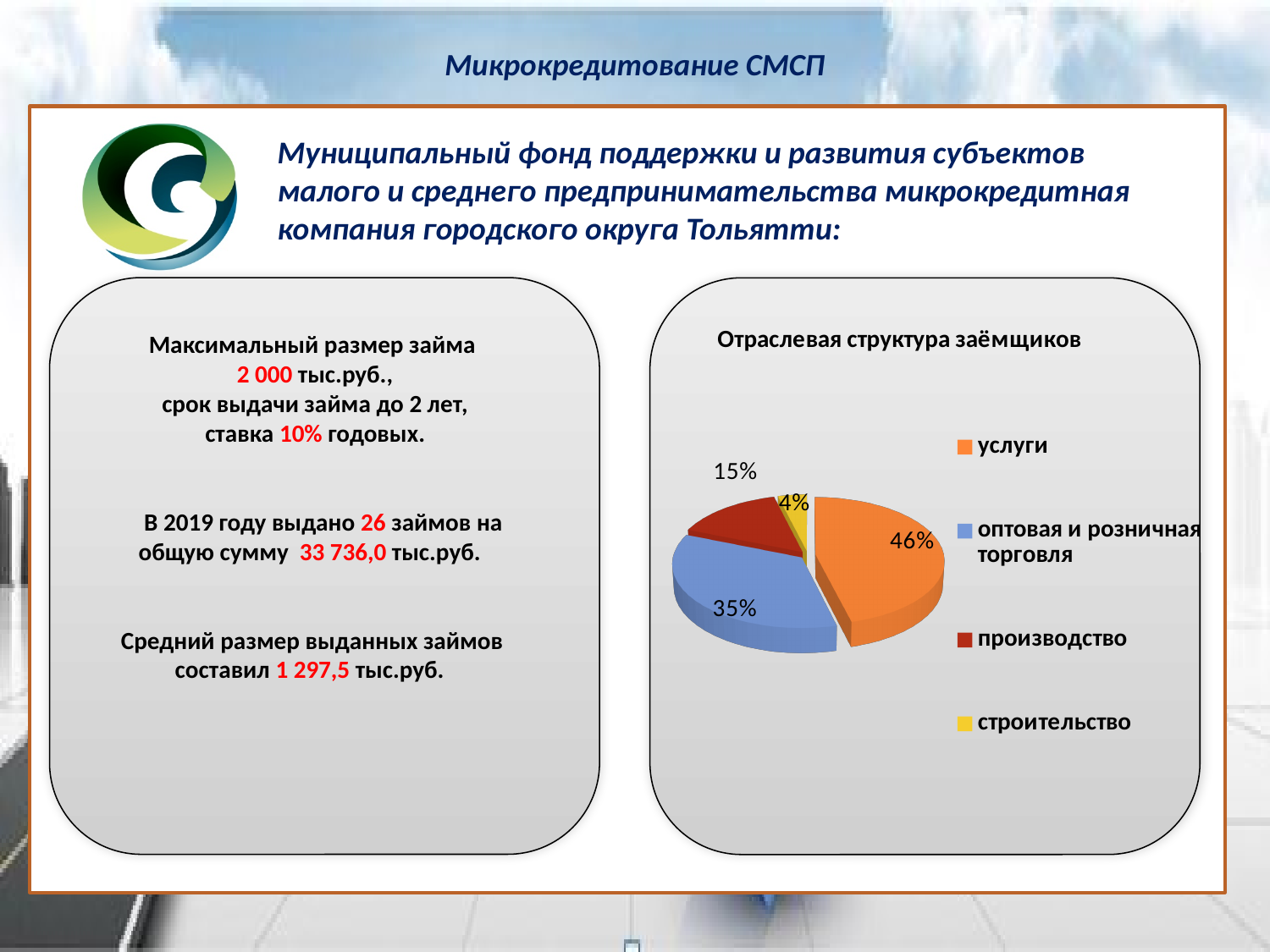
What colour is the slice for оптовая и розничная торговля? blue How many categories does the pie chart show? 4 Which is larger, the share for производство or the share for строительство? производство Which category has the smallest share of the pie? строительство What share of the pie does оптовая и розничная торговля account for? 35% What type of chart is shown on the slide? pie chart What share of the pie does строительство account for? 4% What share of the pie does производство account for? 15% Which category has the largest share of the pie? услуги What is the title of the chart on the slide? Отраслевая структура заёмщиков What is the difference in percentage points between услуги and оптовая и розничная торговля? 11